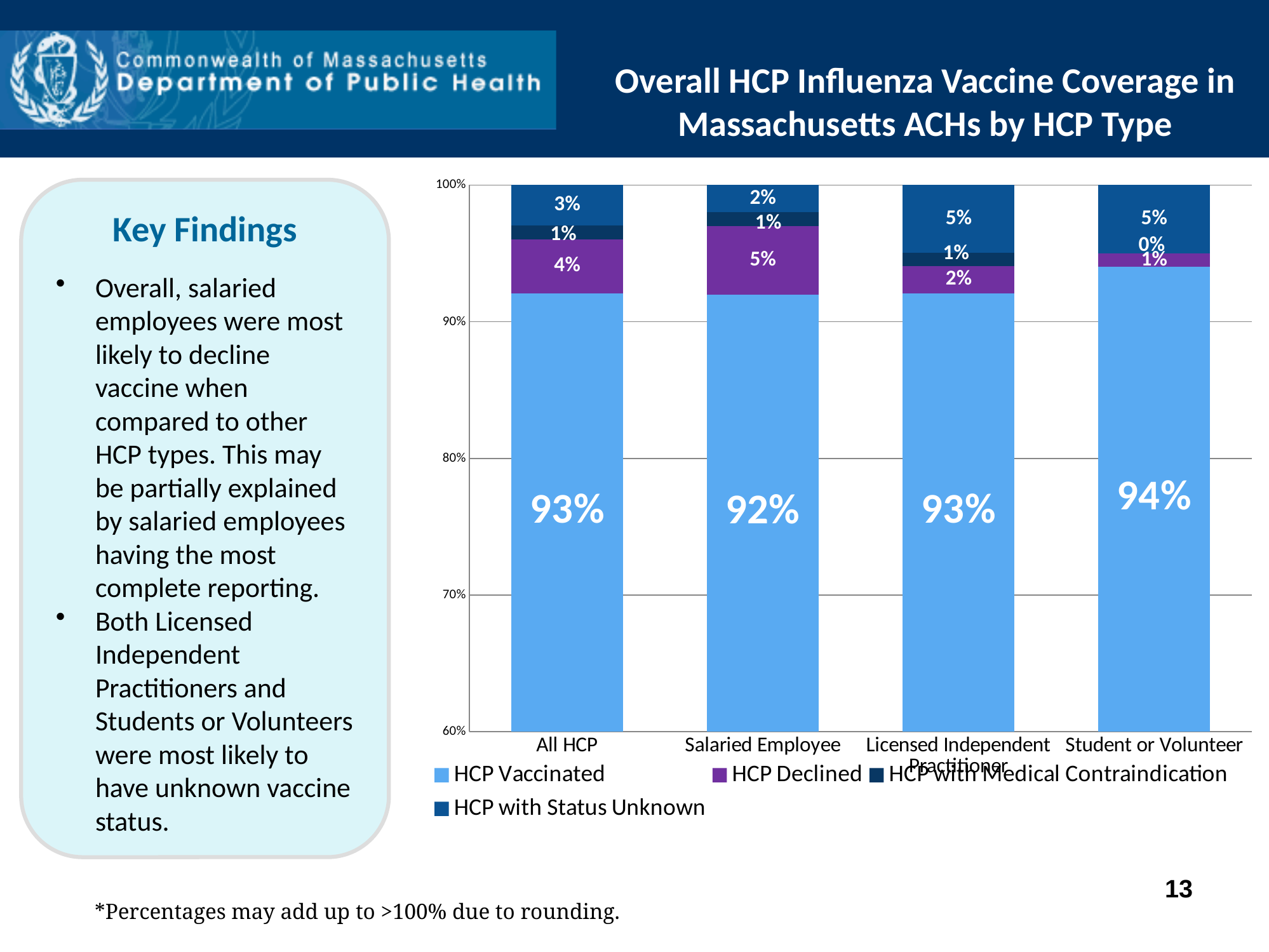
Which has a larger HCP with Status Unknown percentage, All HCP or Salaried Employee? All HCP What kind of chart is shown on the slide? Stacked bar chart What is the difference in HCP Declined percentage between Salaried Employee and Student or Volunteer? 4 percentage points What is the HCP Vaccinated percentage for Student or Volunteer? 94% What is the HCP Declined percentage for All HCP? 4% What is the HCP Vaccinated percentage for Salaried Employee? 92% How many series does the legend list? 4 Which HCP type has the highest HCP Declined percentage? Salaried Employee What is the HCP with Status Unknown percentage for Licensed Independent Practitioner? 5% How many HCP type categories are shown on the x axis? 4 Which HCP type has the lowest HCP Vaccinated percentage? Salaried Employee Which HCP type has the highest HCP Vaccinated percentage? Student or Volunteer